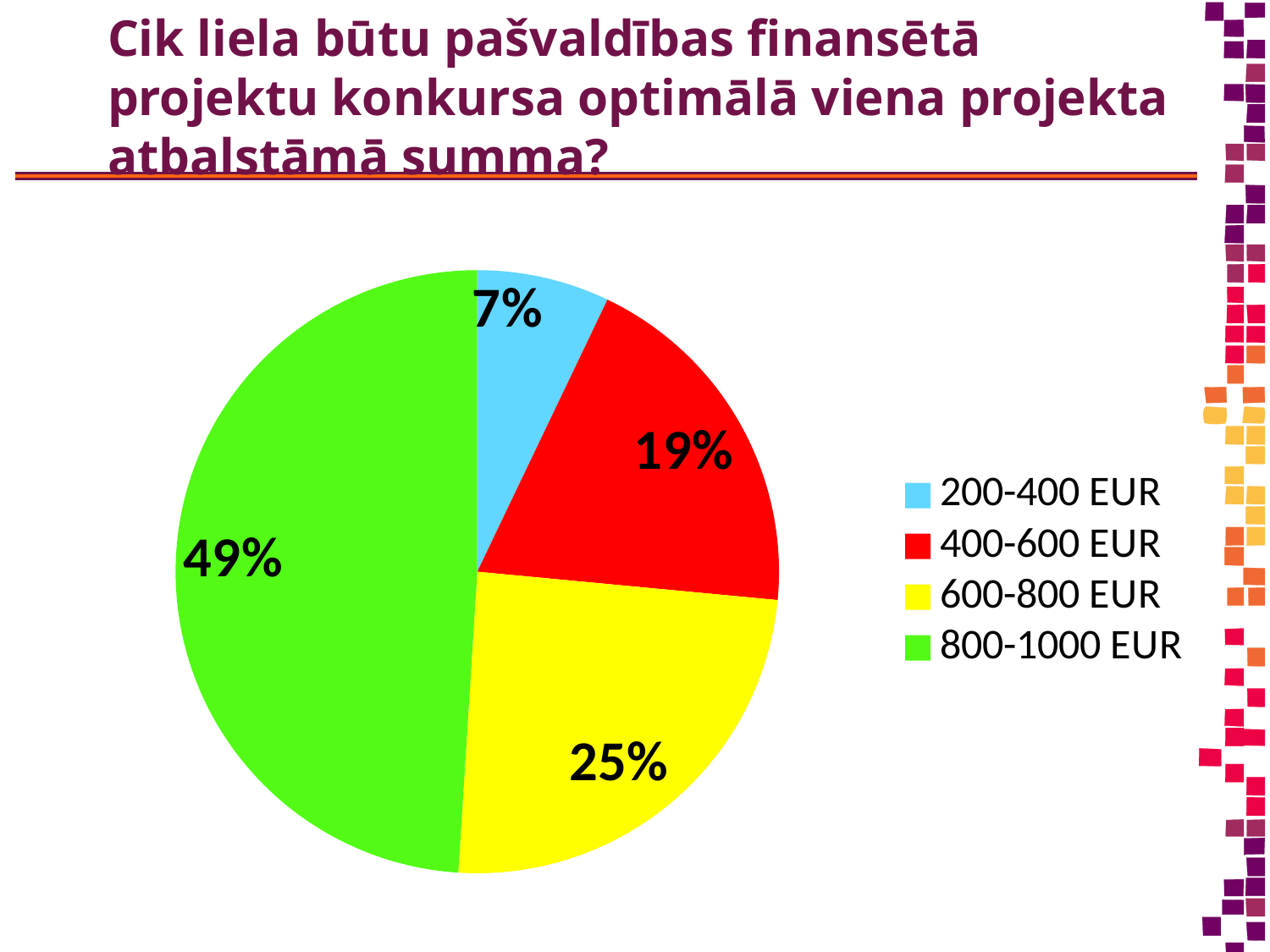
What is the difference between the shares for 800-1000 EUR and 600-800 EUR? 24% What kind of chart is shown on the slide? pie chart How many categories does the pie chart have? 4 What is the difference between the shares for 400-600 EUR and 200-400 EUR? 12% Which is larger, the share for 600-800 EUR or the share for 400-600 EUR? 600-800 EUR What share of the pie does the 800-1000 EUR slice represent? 49% What colour is the slice for 600-800 EUR? yellow What is the value shown for 600-800 EUR? 25% What is the value shown for 200-400 EUR? 7% Which category has the smallest share of the pie? 200-400 EUR What is the value shown for 400-600 EUR? 19% Which category has the largest share of the pie? 800-1000 EUR